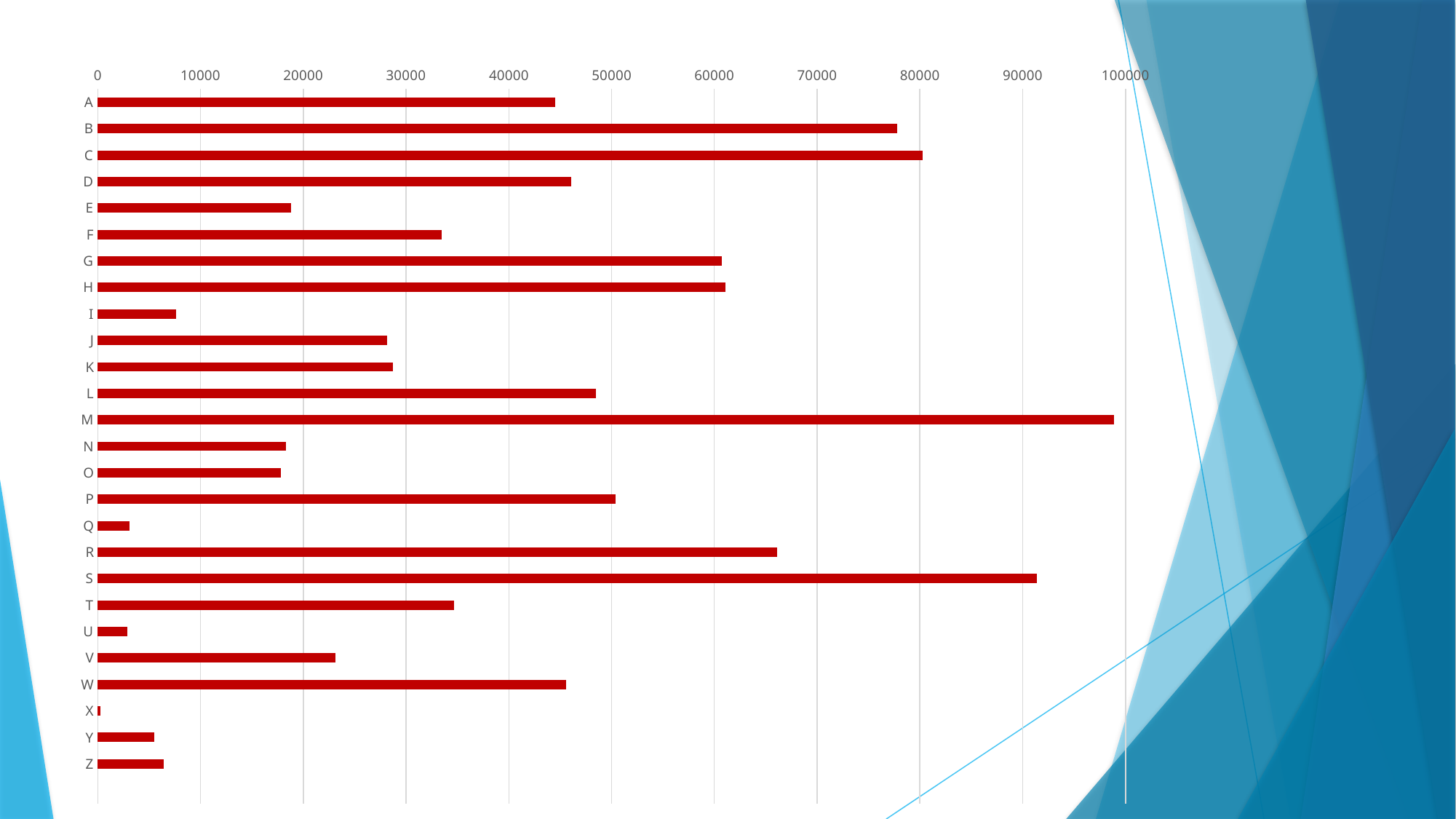
Is the value for Q greater or less than 10000? less How many categories are plotted on the chart? 26 Is the value for E greater or less than 20000? less Is the value for M greater or less than 90000? greater Which has the larger value, S or R? S Which has the larger value, C or A? C Which category has the highest value? M Which category has the lowest value? X What colour are the bars in the chart? red What kind of chart is shown on the slide? bar chart